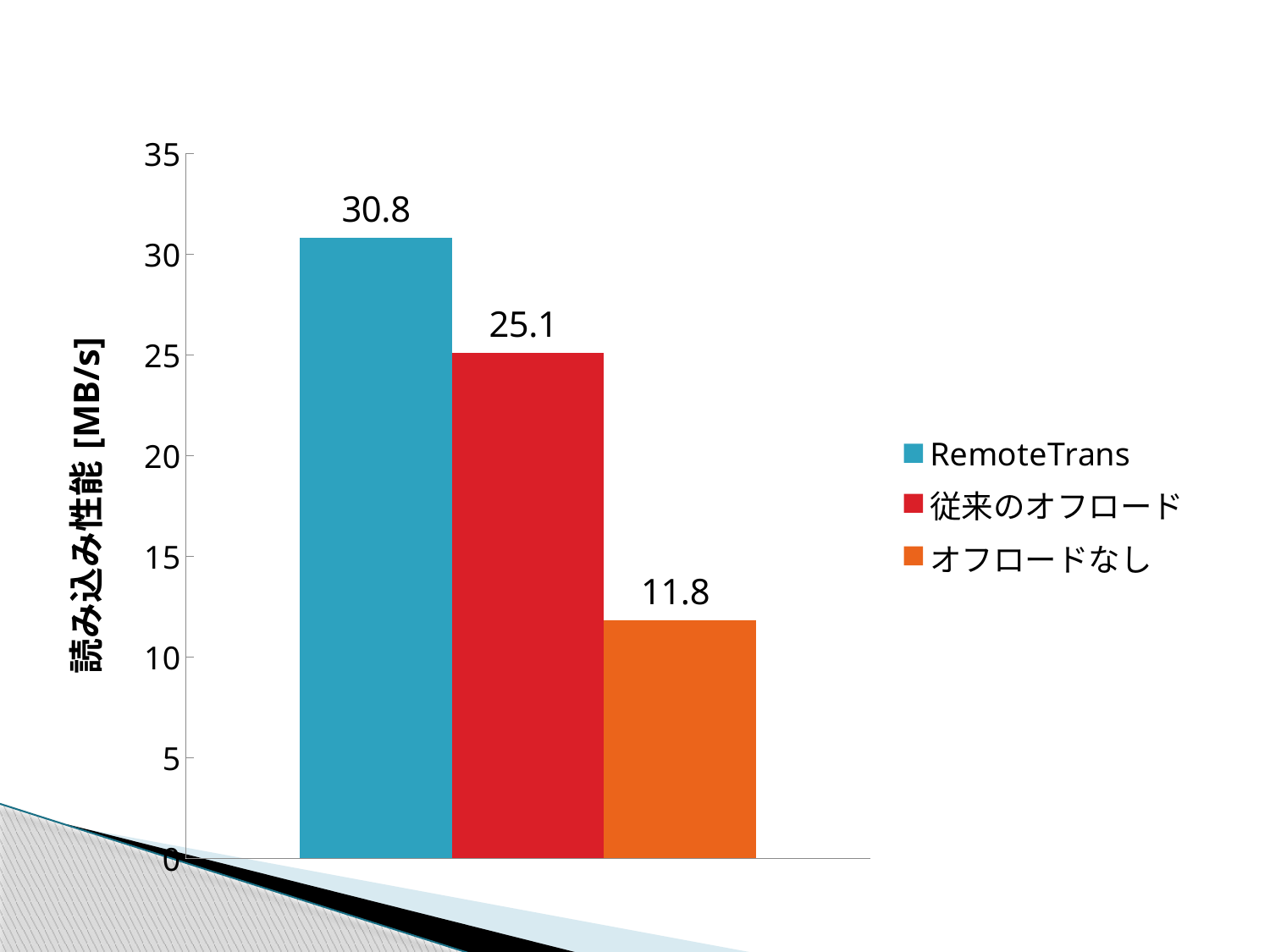
What kind of chart is shown on the slide? bar chart What is the read performance value for オフロードなし? 11.8 What is the difference between the 従来のオフロード value and the オフロードなし value? 13.3 What is the difference between the RemoteTrans value and the 従来のオフロード value? 5.7 Which series has the highest read performance? RemoteTrans Which series has the lowest read performance? オフロードなし Is the value for 従来のオフロード greater or less than 20? greater What is the label of the vertical axis? 読み込み性能 [MB/s] What is the read performance value for RemoteTrans? 30.8 Which is larger, the value for RemoteTrans or the value for オフロードなし? RemoteTrans How many series does the legend list? 3 What is the read performance value for 従来のオフロード? 25.1